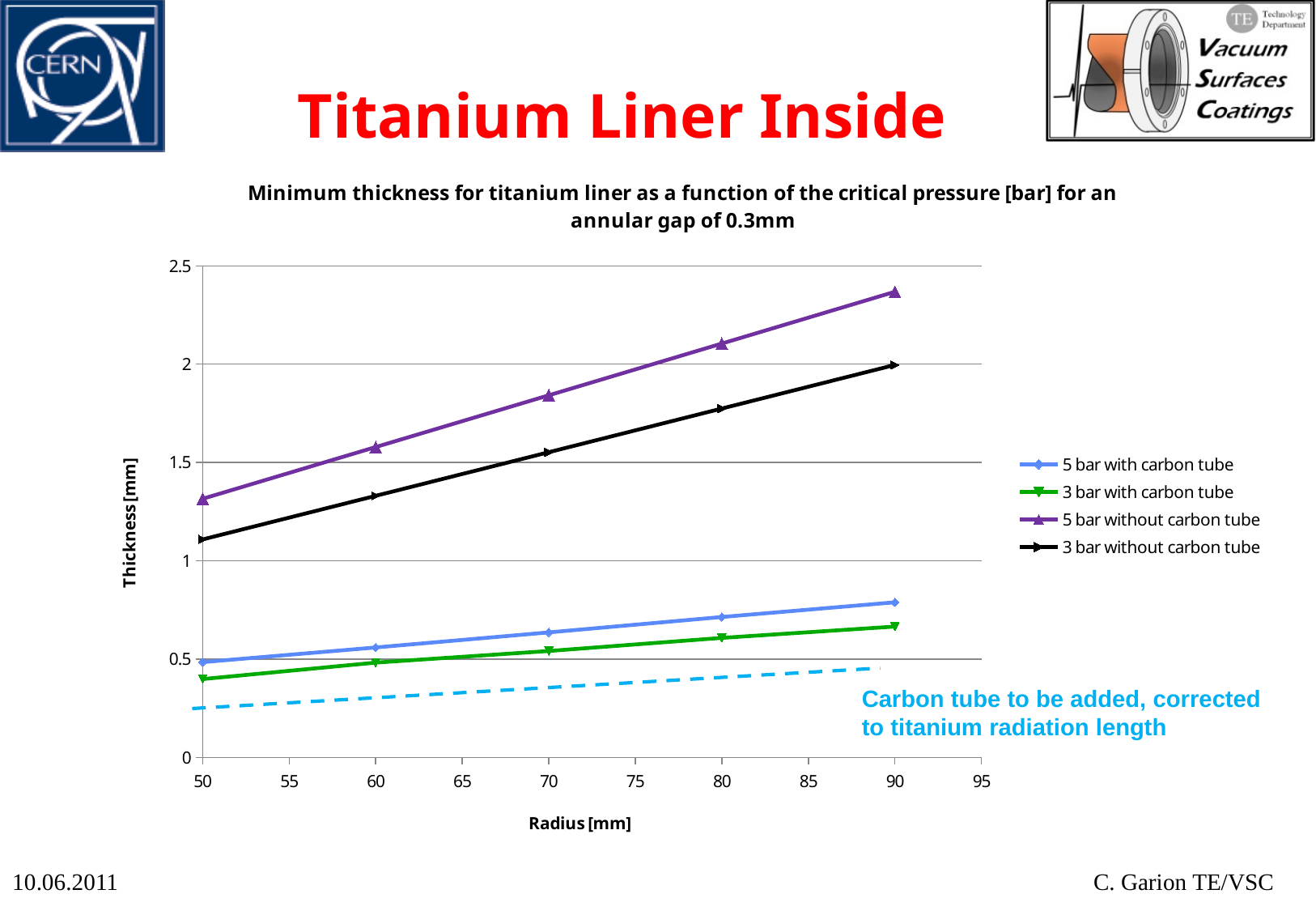
Which series has the highest thickness at a radius of 90 mm? 5 bar without carbon tube What is the label of the x axis of the chart? Radius [mm] At a radius of 70 mm, which is larger: the thickness for '5 bar without carbon tube' or for '3 bar without carbon tube'? 5 bar without carbon tube Is the thickness for '5 bar without carbon tube' at a radius of 90 mm greater or less than 2? greater How many series does the legend list? 4 How many data points are plotted for the '5 bar without carbon tube' series? 5 Which series has the lowest thickness at a radius of 50 mm? 3 bar with carbon tube Is the thickness for '3 bar without carbon tube' at a radius of 50 mm greater or less than 1? greater Is the thickness for '5 bar with carbon tube' at a radius of 90 mm greater or less than 1? less What kind of chart is shown on the slide? line chart Does the thickness for '3 bar without carbon tube' rise or fall as the radius increases? rise